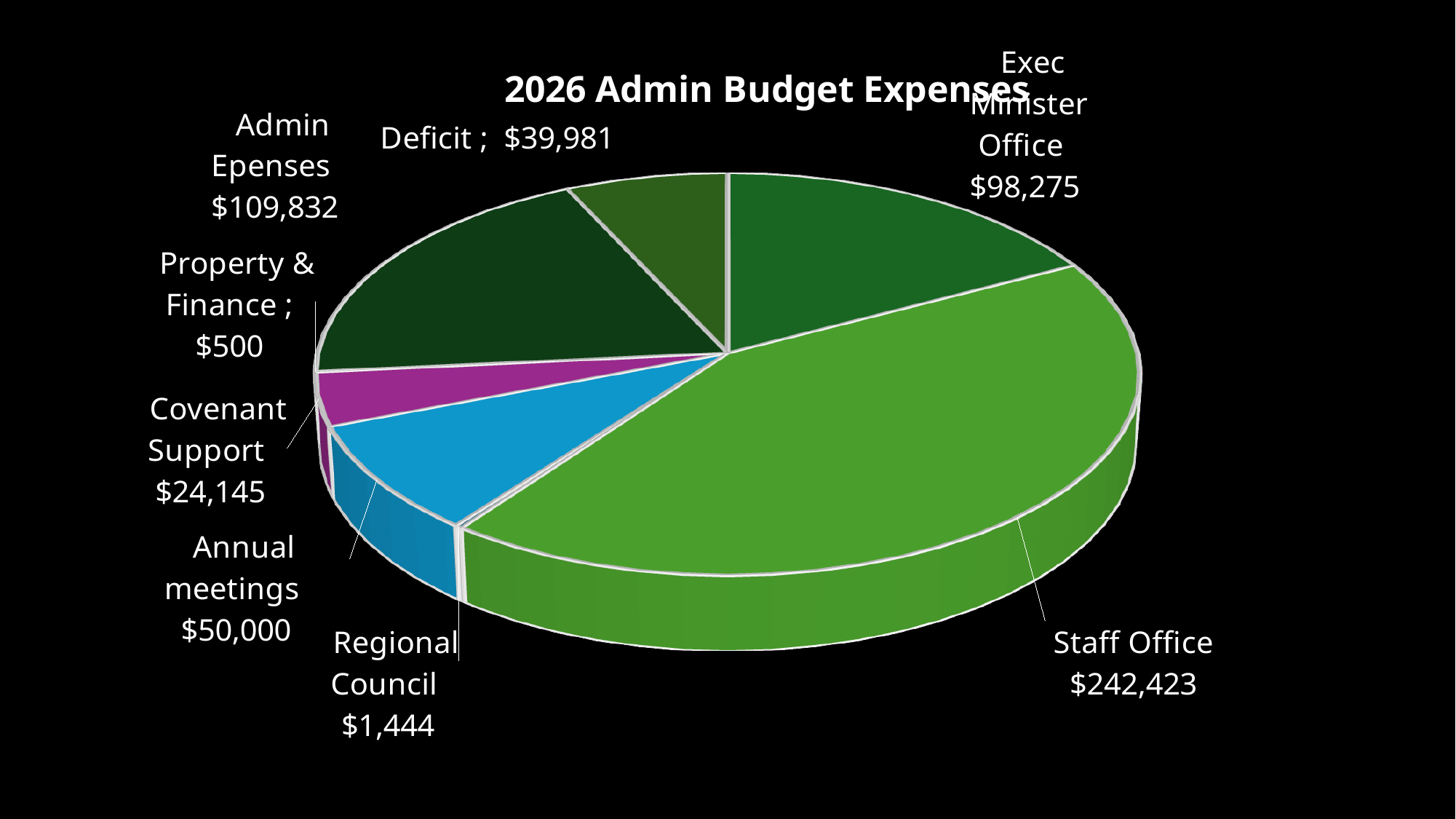
What is the difference between Covenant Support and Property & Finance? $23,645 Which category has the largest slice of the pie? Staff Office What is the difference between Staff Office and Exec Minister Office? $144,148 What is the title of the chart? 2026 Admin Budget Expenses Which category has the smallest value? Property & Finance What is the value for Deficit? $39,981 What is the value for Annual meetings? $50,000 What kind of chart is shown on the slide? Pie chart What is the value for Staff Office? $242,423 How many slices does the pie chart have? 8 Which is larger, Admin Epenses or Annual meetings? Admin Epenses What is the value for Exec Minister Office? $98,275